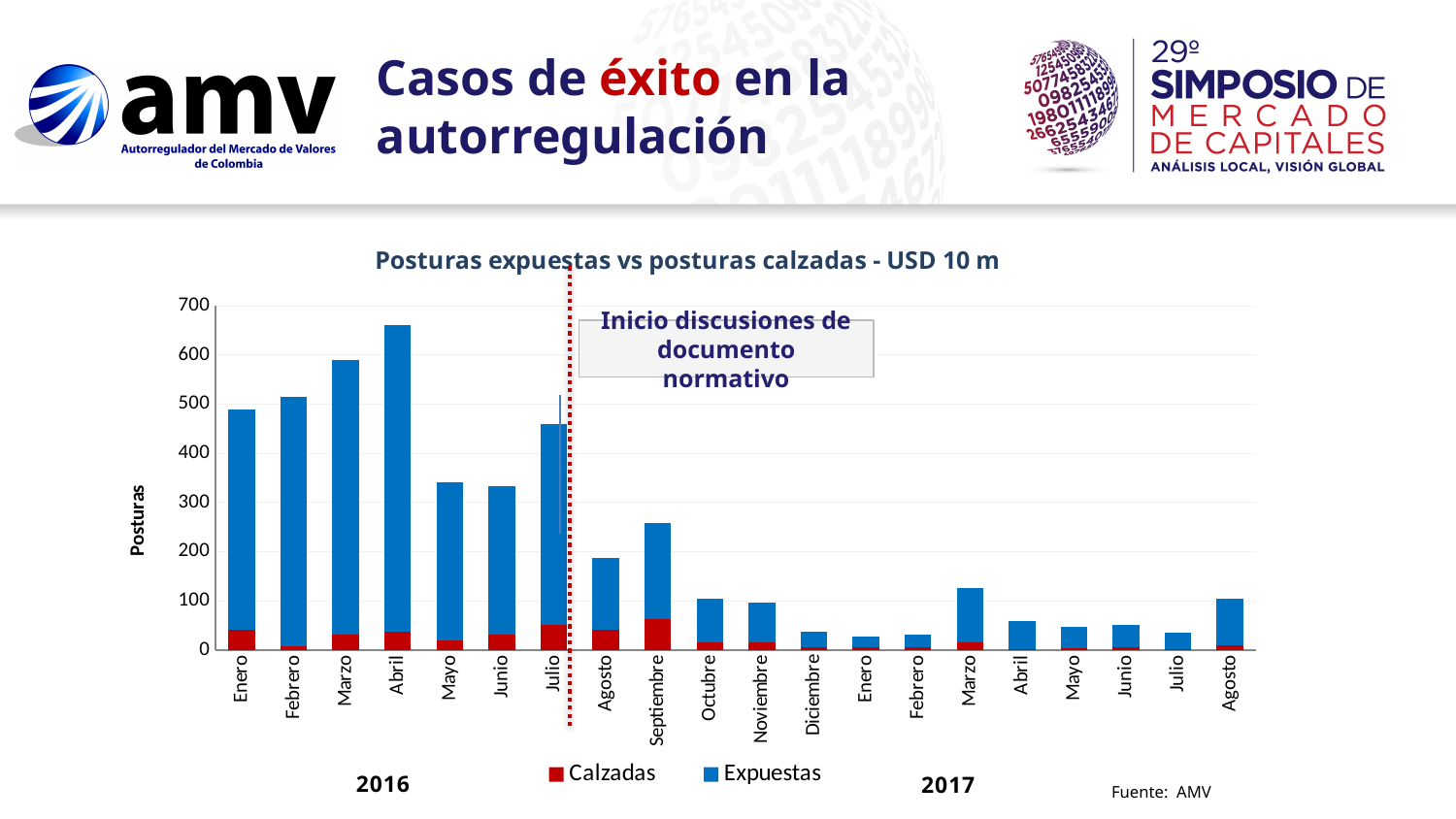
Is the total bar for Marzo 2016 greater or less than 500? greater What kind of chart is shown on the slide? Stacked bar chart How many series does the chart legend list? 2 Is the total bar for Abril 2016 greater or less than 600? greater Do the bar totals rise or fall from Enero 2016 to Abril 2016? Rise What are the two series named in the legend? Calzadas and Expuestas Is the total bar for Agosto 2016 greater or less than 200? less What is the title of the chart? Posturas expuestas vs posturas calzadas - USD 10 m Which month has the tallest bar in the chart? Abril 2016 How many monthly bars are plotted in the chart? 20 Which bar is taller, Marzo 2016 or Mayo 2016? Marzo 2016